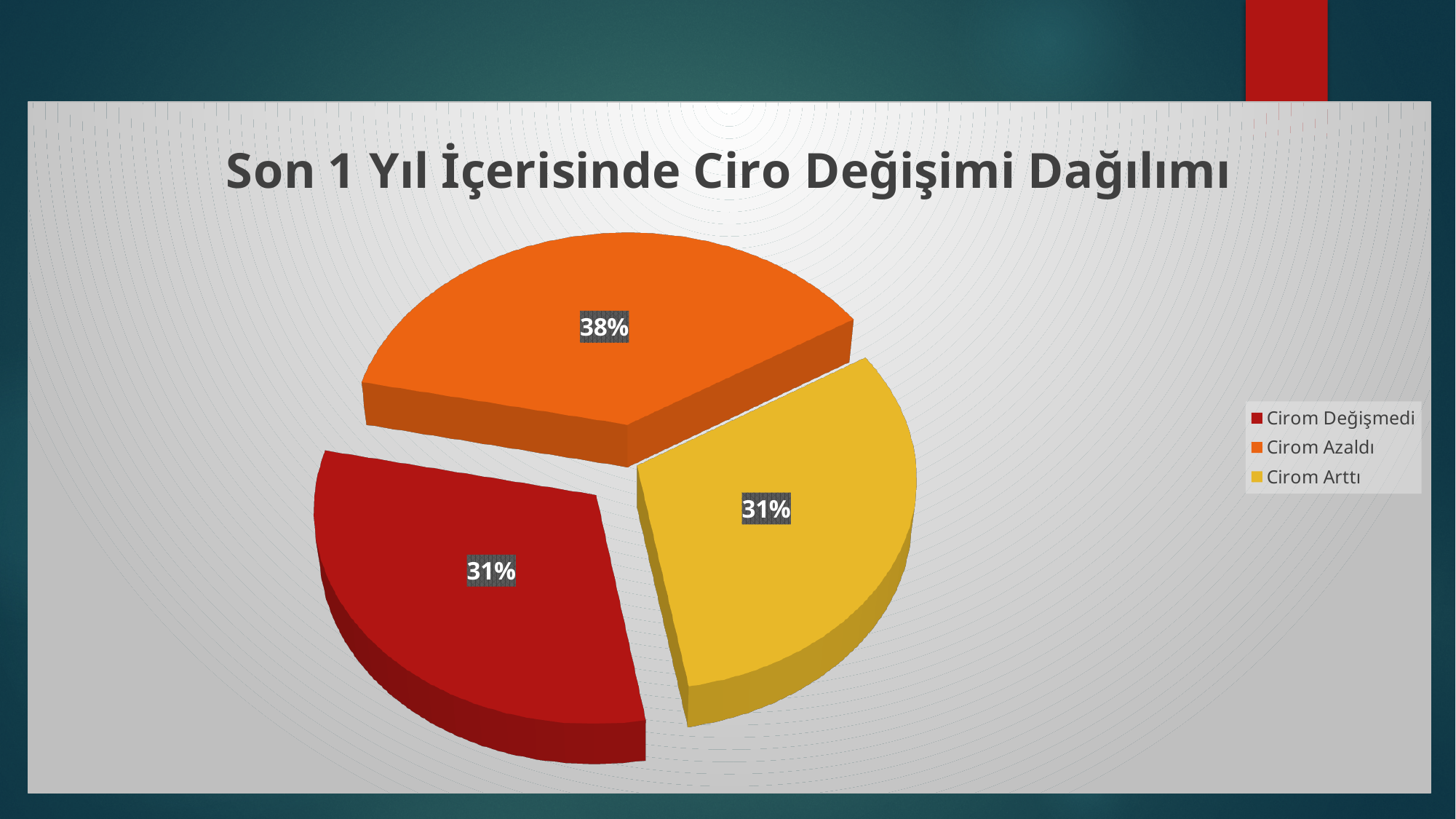
Which colour represents "Cirom Arttı" in the legend? Yellow What is the value shown for "Cirom Değişmedi"? 31% How many slices does the pie chart have? 3 What share of the pie does the "Cirom Azaldı" slice represent? 38% Is the value for "Cirom Azaldı" greater or less than 35%? greater What kind of chart is shown on the slide? Pie chart Which category has the largest slice of the pie? Cirom Azaldı What is the difference in percentage points between "Cirom Azaldı" and "Cirom Arttı"? 7 percentage points What is the title of the chart? Son 1 Yıl İçerisinde Ciro Değişimi Dağılımı Which is larger, the share for "Cirom Azaldı" or the share for "Cirom Değişmedi"? Cirom Azaldı What is the value shown for "Cirom Arttı"? 31%